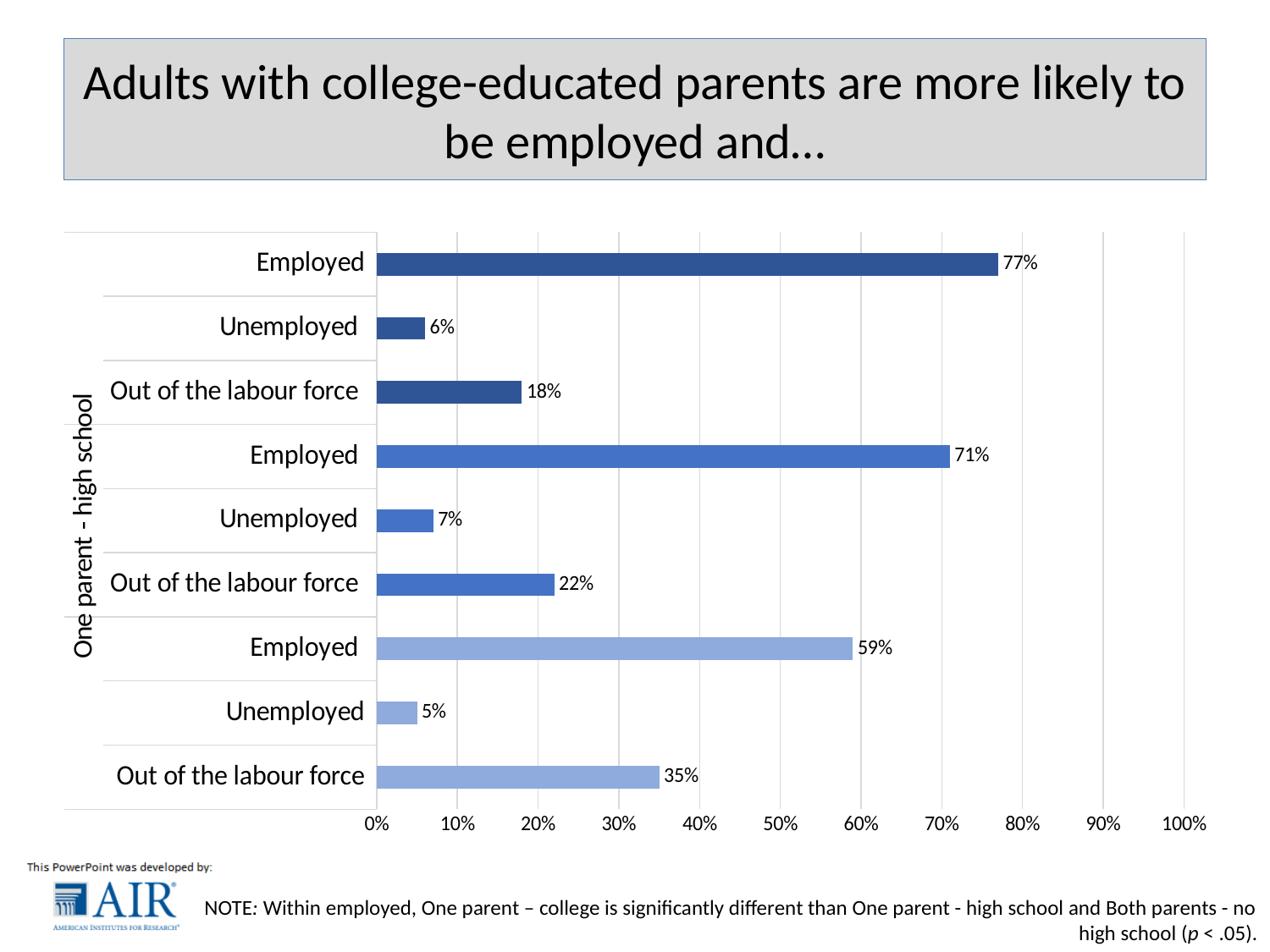
Is the value of the bottommost Out of the labour force bar greater or less than 30%? greater What is the Unemployed value for the One parent - high school group? 7% Which is larger: the topmost Out of the labour force bar or the bottommost Out of the labour force bar? The bottommost Out of the labour force bar (35%) What kind of chart is shown on the slide? Bar chart What is the value of the bottommost Out of the labour force bar? 35% What is the difference between the topmost Employed bar (77%) and the bottommost Employed bar (59%)? 18 percentage points How many bars are plotted in the chart? 9 What is the Employed value for the One parent - high school group? 71% Which bar has the lowest value in the chart? The bottommost Unemployed bar (5%) What is the value of the topmost Employed bar in the chart? 77% Which bar has the highest value in the chart? The topmost Employed bar (77%) What is the maximum value shown on the horizontal axis of the chart? 100%